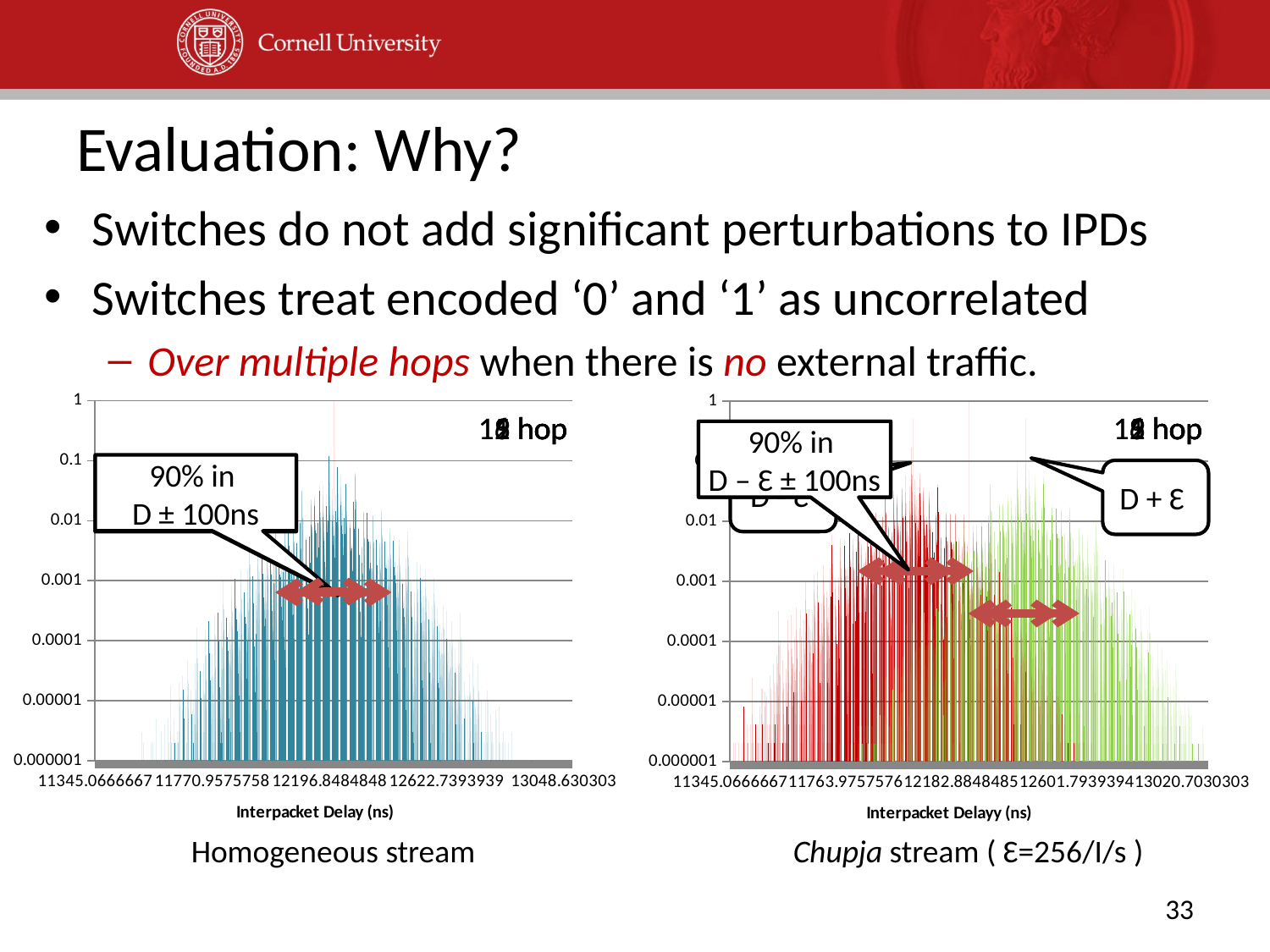
In the Homogeneous stream chart on the left, is the tallest bar greater or less than 0.001? greater What is the x-axis title of the Chupja stream chart on the right? Interpacket Delayy (ns) What kind of chart is the Homogeneous stream chart on the left? bar chart What kind of chart is the Chupja stream chart on the right? bar chart In the Homogeneous stream chart on the left, is the tallest bar greater or less than 1? less What is the x-axis title of the Homogeneous stream chart on the left? Interpacket Delay (ns) In the Chupja stream chart on the right, is the tallest bar greater or less than 0.001? greater